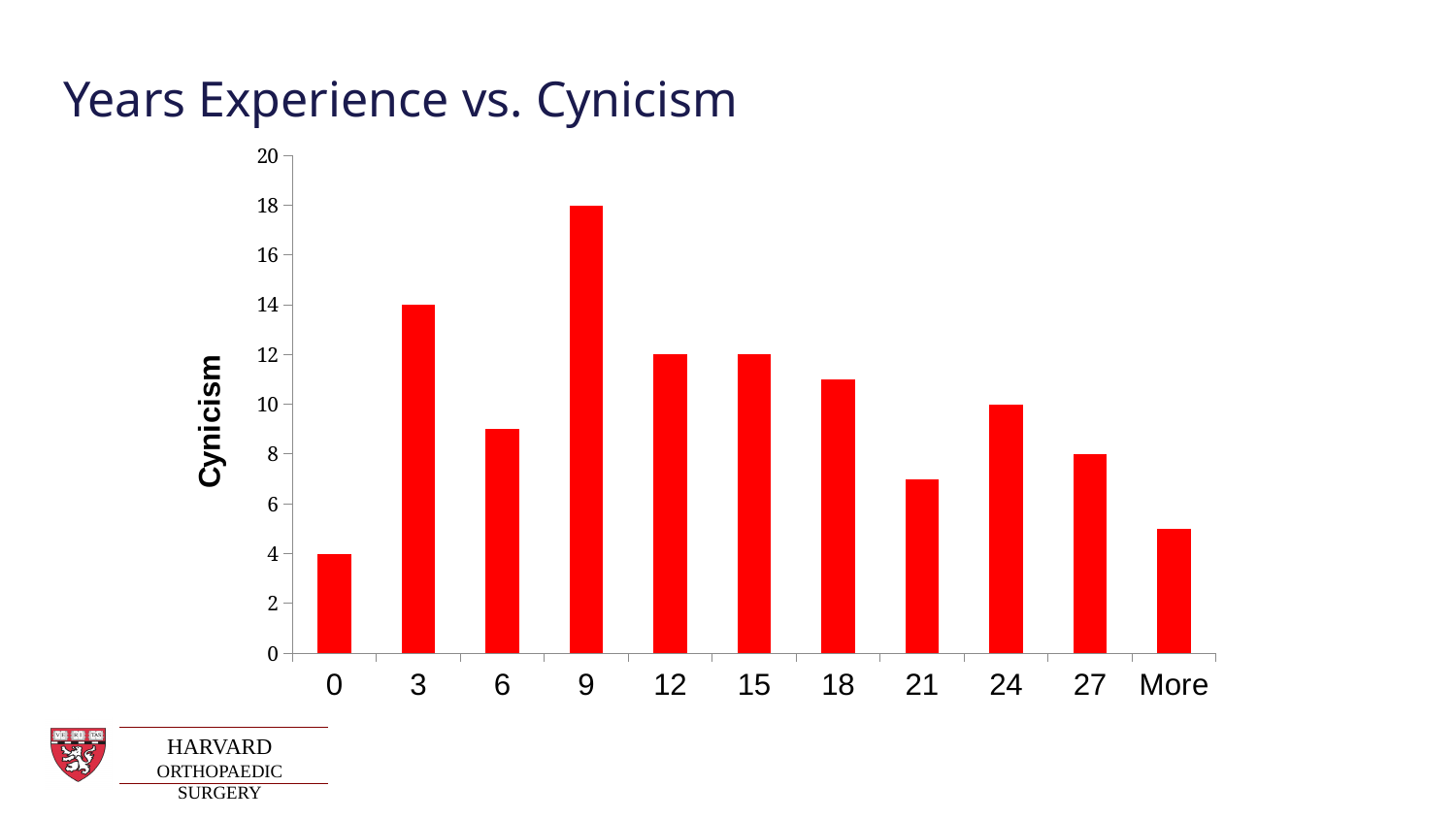
What is the Cynicism value for the category 0? 4 Which category has the lowest Cynicism value? 0 What type of chart is shown on the slide? bar chart What is the title of the chart? Years Experience vs. Cynicism Which has a larger Cynicism value, category 24 or category 27? 24 Which category has the highest Cynicism value? 9 Is the Cynicism value for the category 6 greater or less than 8? greater What is the difference between the Cynicism values for categories 9 and 3? 4 Is the Cynicism value for the category 21 greater or less than 8? less What is the Cynicism value for the category 9? 18 How many categories are shown on the x axis? 11 What is the Cynicism value for the category 3? 14